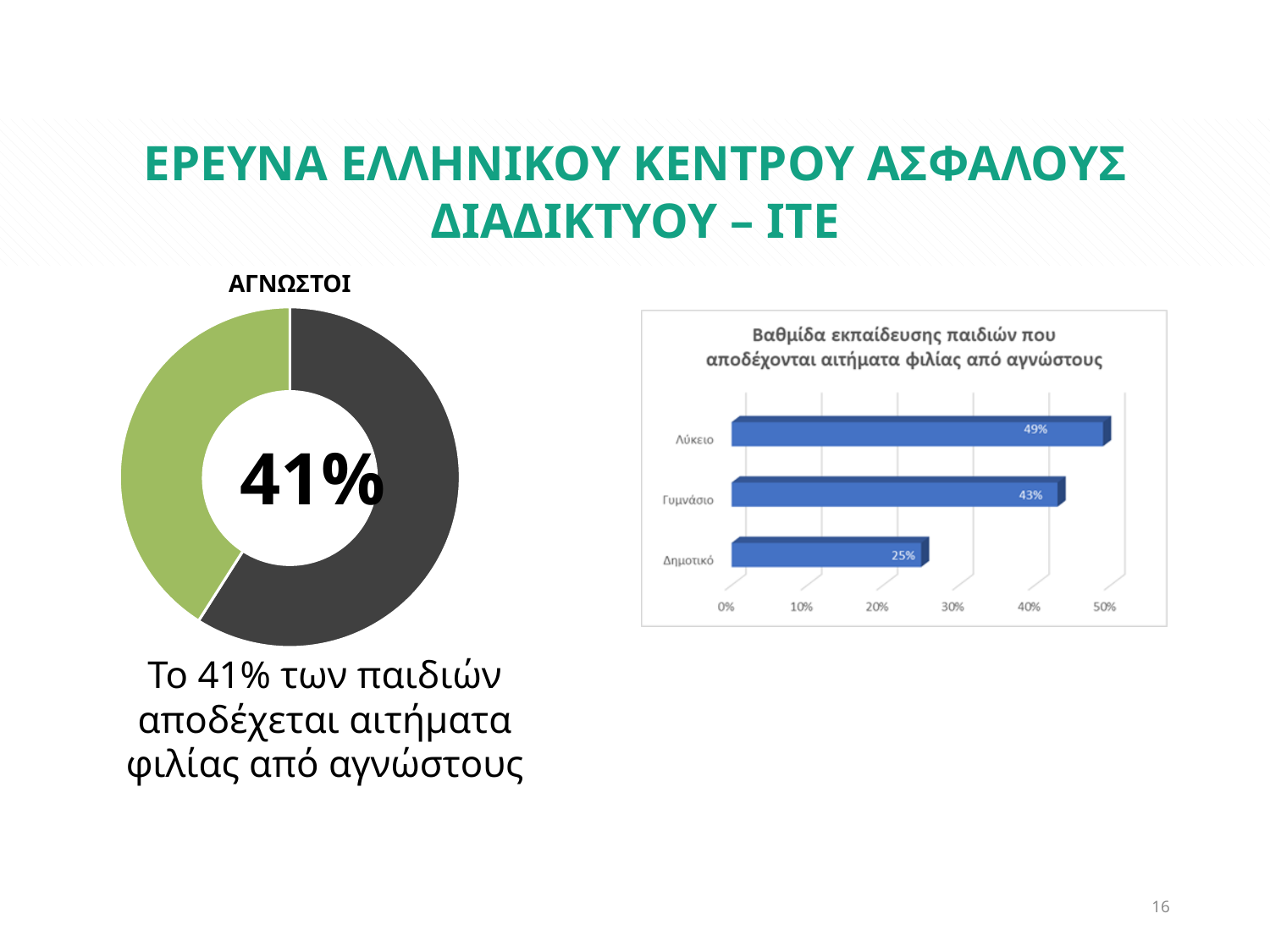
In the bar chart on the right, what is the value for Γυμνάσιο? 43% In the bar chart on the right, is the value for Δημοτικό greater or less than 30%? less In the bar chart on the right, which category has the lowest value? Δημοτικό In the bar chart on the right, what is the value for Λύκειο? 49% In the bar chart on the right, what is the difference between the values for Λύκειο and Γυμνάσιο? 6% What percentage is shown in the centre of the donut chart titled ΑΓΝΩΣΤΟΙ on the left? 41% In the bar chart on the right, what is the value for Δημοτικό? 25% In the bar chart on the right, which category has the highest value? Λύκειο How many categories are shown in the bar chart on the right? 3 What kind of chart is the chart on the right of the slide? Bar chart In the bar chart on the right, which is larger, the value for Γυμνάσιο or the value for Δημοτικό? Γυμνάσιο In the bar chart on the right, what is the difference between the values for Λύκειο and Δημοτικό? 24%